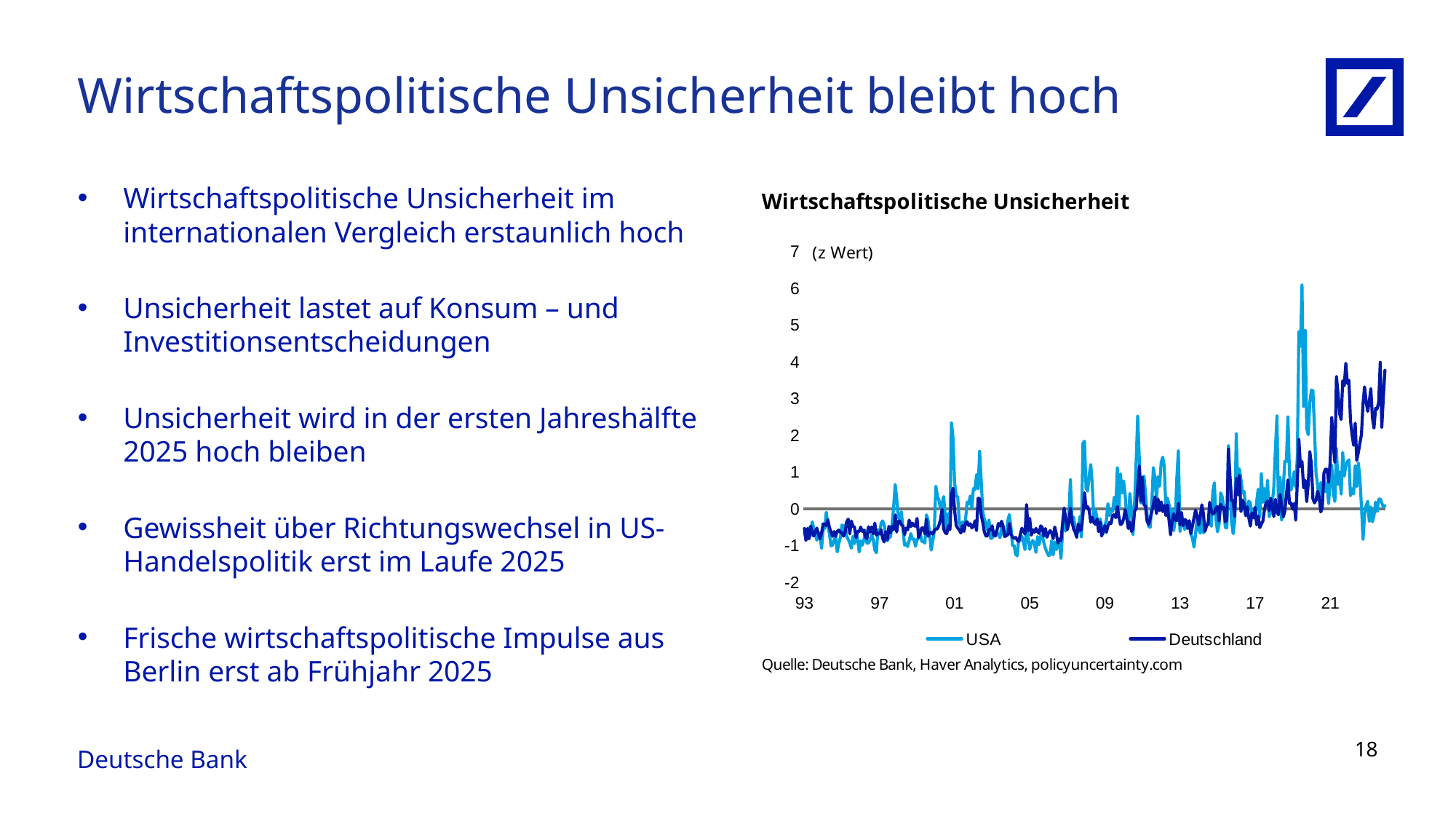
Is the value of the USA series at the right end of the chart greater or less than 1? less Does the Deutschland series generally rise or fall from the left to the right of the chart? rise At the right end of the chart, which series has the larger value, USA or Deutschland? Deutschland What is the first year label shown on the x axis of the chart? 93 Which series reaches the highest peak in the chart, USA or Deutschland? USA Is the highest value of the Deutschland series greater or less than 3? greater Is the value of the Deutschland series at the right end of the chart greater or less than 2? greater Which two series are shown in the chart's legend? USA and Deutschland What unit is indicated at the top of the y axis of the chart? z Wert How many series does the legend of the chart list? 2 What kind of chart is shown on the slide? line chart